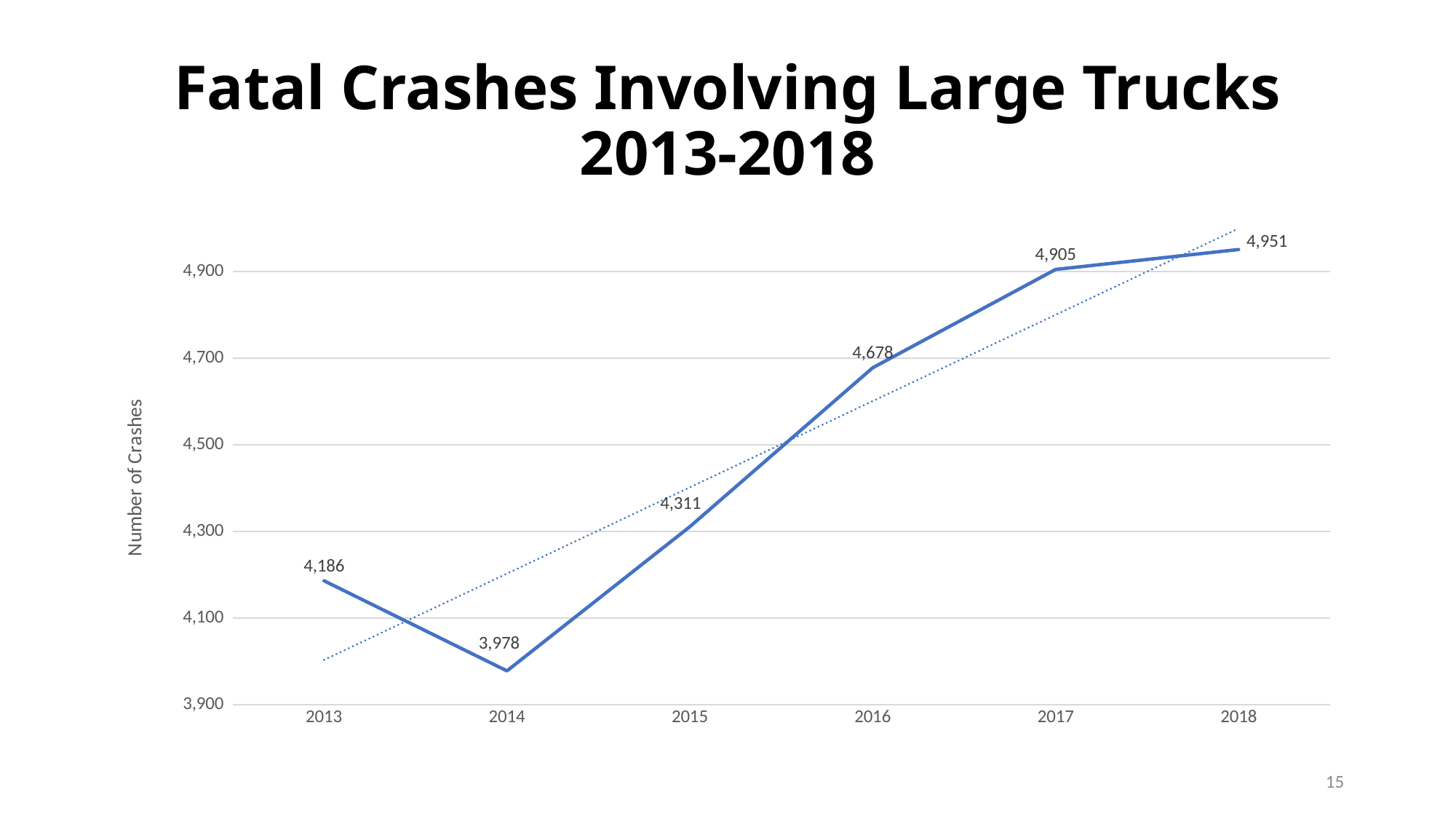
What is the number of fatal crashes involving large trucks in 2013? 4,186 What is the label on the vertical axis of the chart? Number of Crashes What is the number of fatal crashes involving large trucks in 2018? 4,951 What is the difference in fatal crashes between 2017 and 2016? 227 How many years are plotted on the chart? 6 Which year has the lowest number of fatal crashes? 2014 Which year has the highest number of fatal crashes? 2018 What is the difference in fatal crashes between 2018 and 2013? 765 What kind of chart is shown on the slide? Line chart Which year had more fatal crashes, 2013 or 2015? 2015 What is the number of fatal crashes involving large trucks in 2014? 3,978 What is the number of fatal crashes involving large trucks in 2016? 4,678